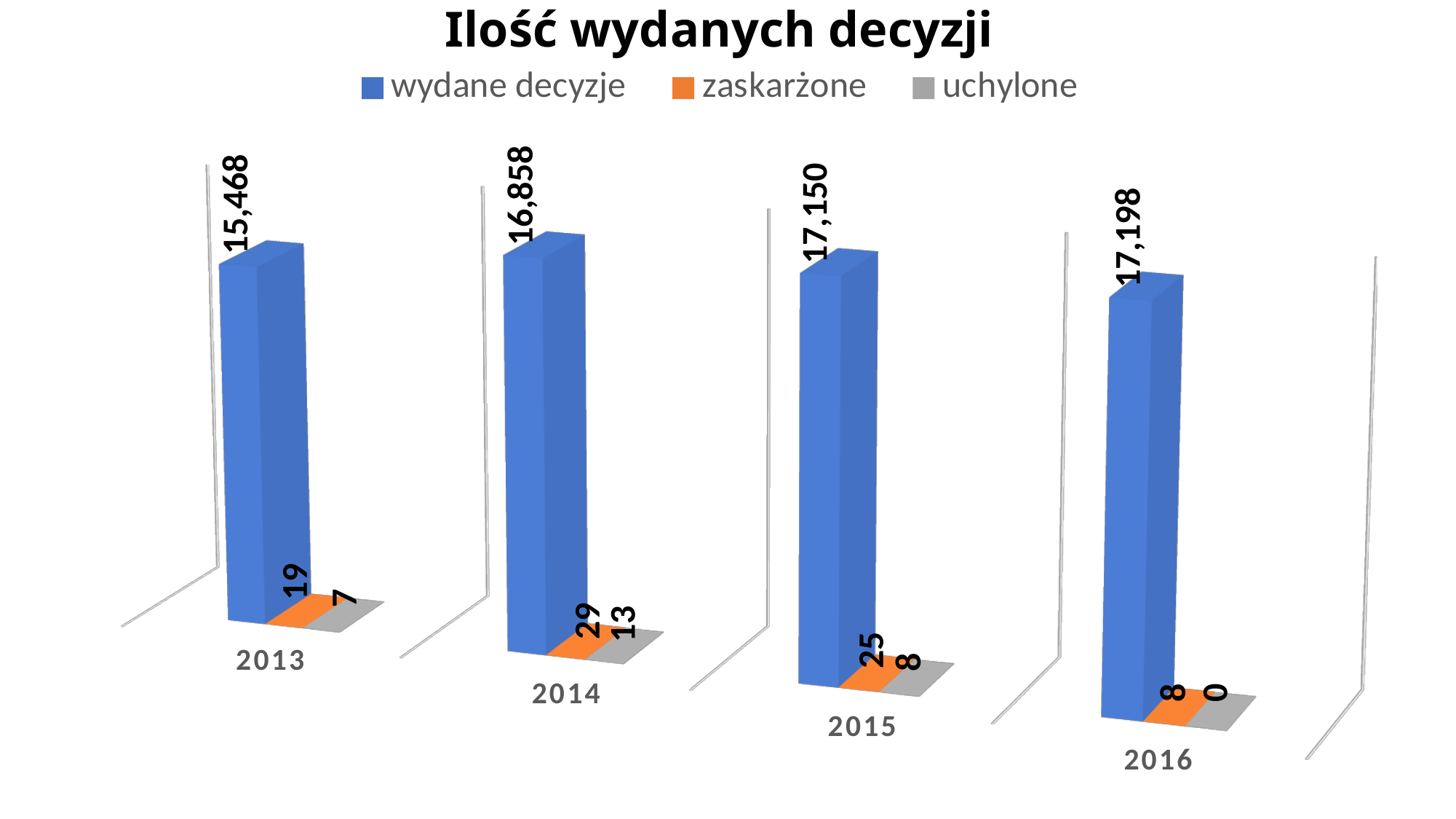
What is the value of 'uchylone' for 2016? 0 How many series does the legend list? 3 Which year has the highest value for 'wydane decyzje'? 2016 What is the difference between 'wydane decyzje' in 2014 and 2013? 1,390 How many years are shown on the x axis? 4 What kind of chart is shown? bar chart Which is larger: 'uchylone' in 2014 or 'uchylone' in 2015? 2014 Does the value of 'wydane decyzje' rise or fall from 2013 to 2016? rise Which year has the lowest value for 'zaskarżone'? 2016 What is the value of 'wydane decyzje' for 2013? 15,468 What is the value of 'zaskarżone' for 2014? 29 What is the value of 'wydane decyzje' for 2015? 17,150